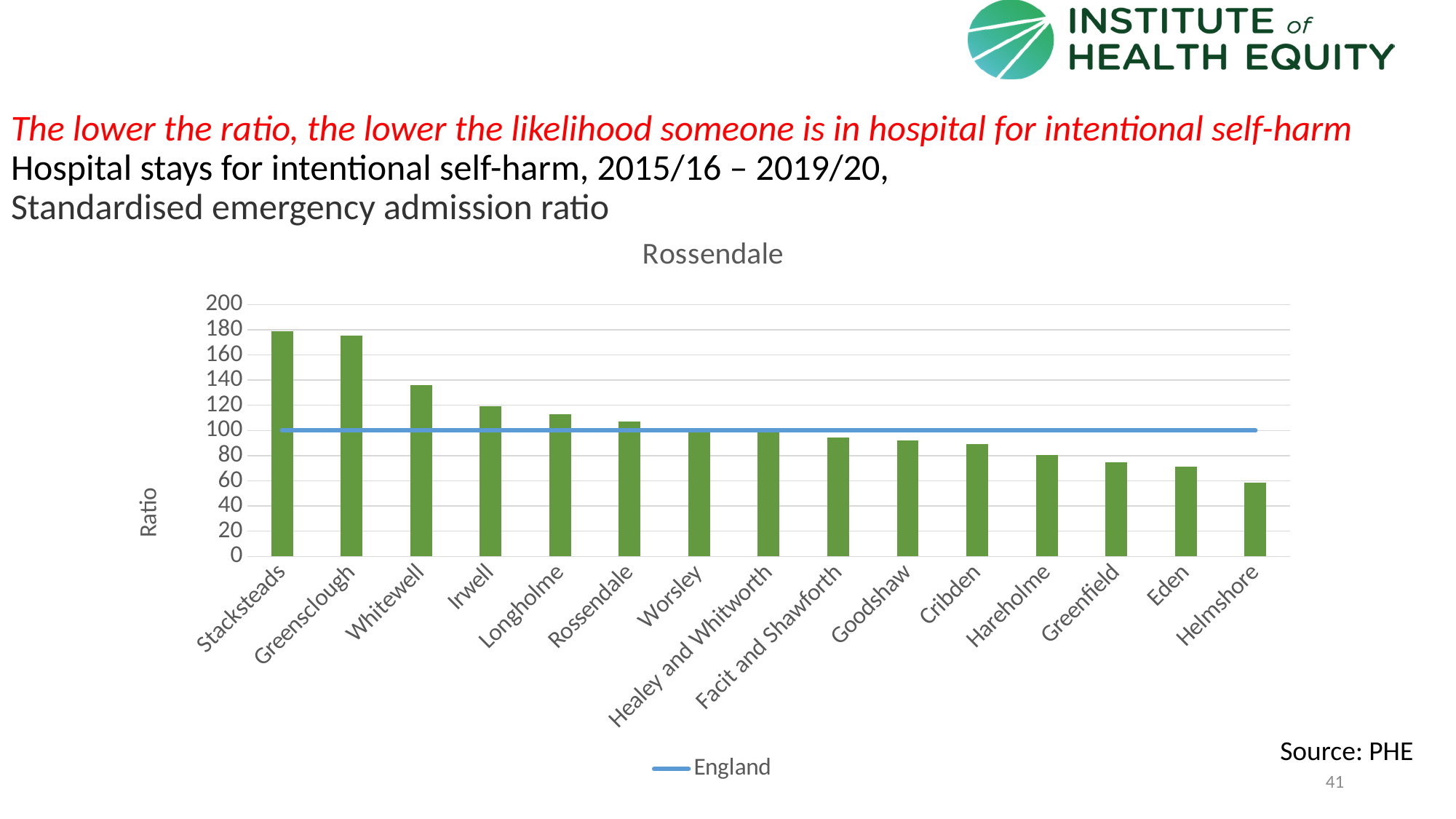
Is the value for Helmshore greater or less than 80? less Which area has the lowest ratio on the chart? Helmshore How many areas (bars) are plotted on the chart? 15 Is the value for Stacksteads greater or less than 160? greater Which is larger, the value for Eden or the value for Longholme? Longholme What kind of chart is shown on the slide? bar chart Do the bar values rise or fall moving from left to right along the x axis? fall What value does the England line sit at on the chart? 100 Is the value for Whitewell greater or less than 120? greater Which is larger, the value for Whitewell or the value for Irwell? Whitewell What series does the legend list? England